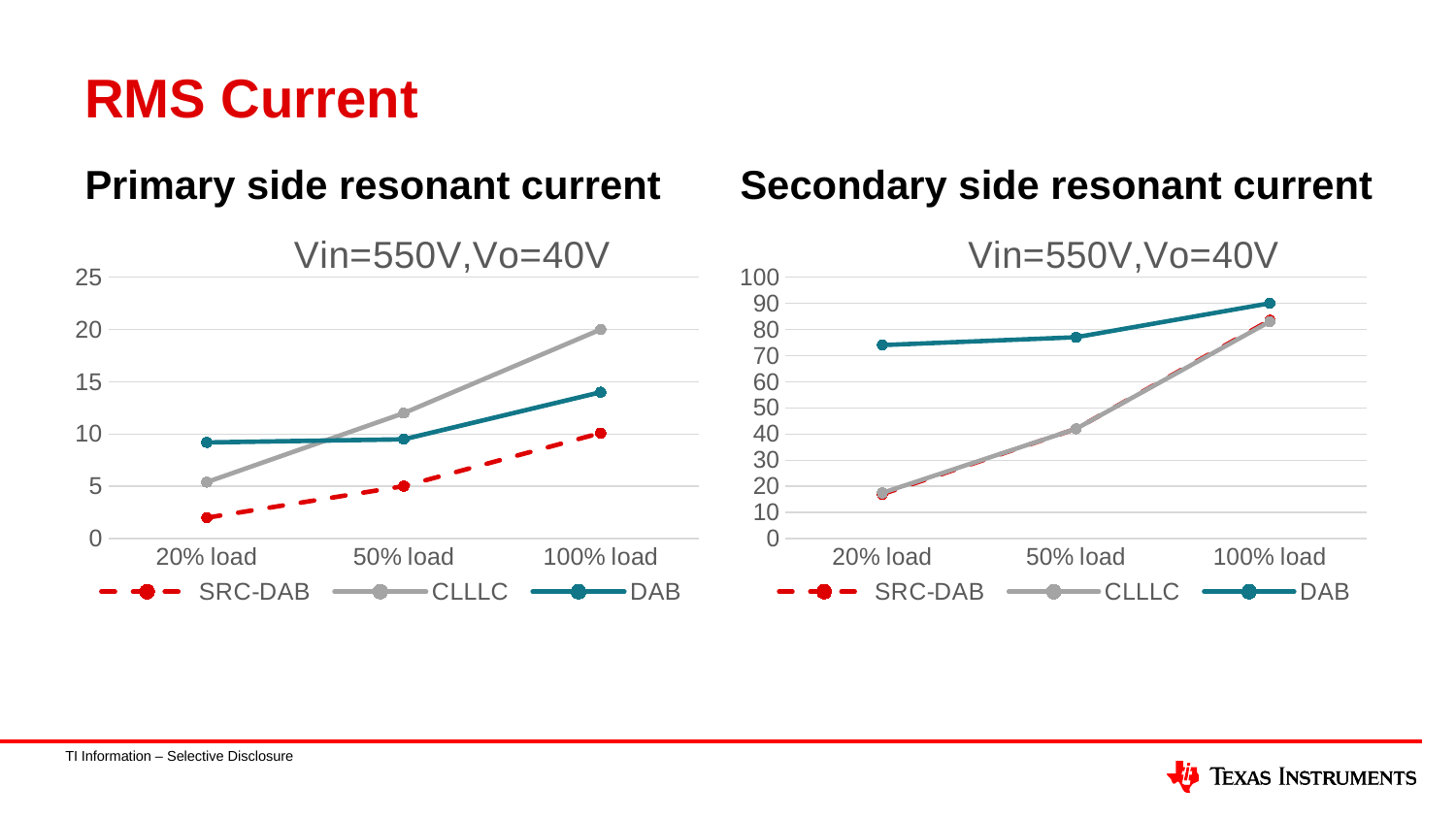
In the Primary side resonant current chart, which series is highest at 100% load? CLLLC In the Secondary side resonant current chart, is the DAB value at 50% load greater or less than 70? greater In the Secondary side resonant current chart, is the CLLLC value at 20% load greater or less than 30? less What kind of chart is the Primary side resonant current chart? line chart In the Primary side resonant current chart, is the SRC-DAB value at 20% load greater or less than 5? less How many load points are plotted along the x axis of the Primary side resonant current chart? 3 What is the subtitle shown above both charts? Vin=550V,Vo=40V In the Primary side resonant current chart, does the SRC-DAB series rise or fall from 20% load to 100% load? rise In the Primary side resonant current chart, which series is lowest at 20% load? SRC-DAB How many series does the legend of the Secondary side resonant current chart list? 3 In the Secondary side resonant current chart, which series is highest at 20% load? DAB